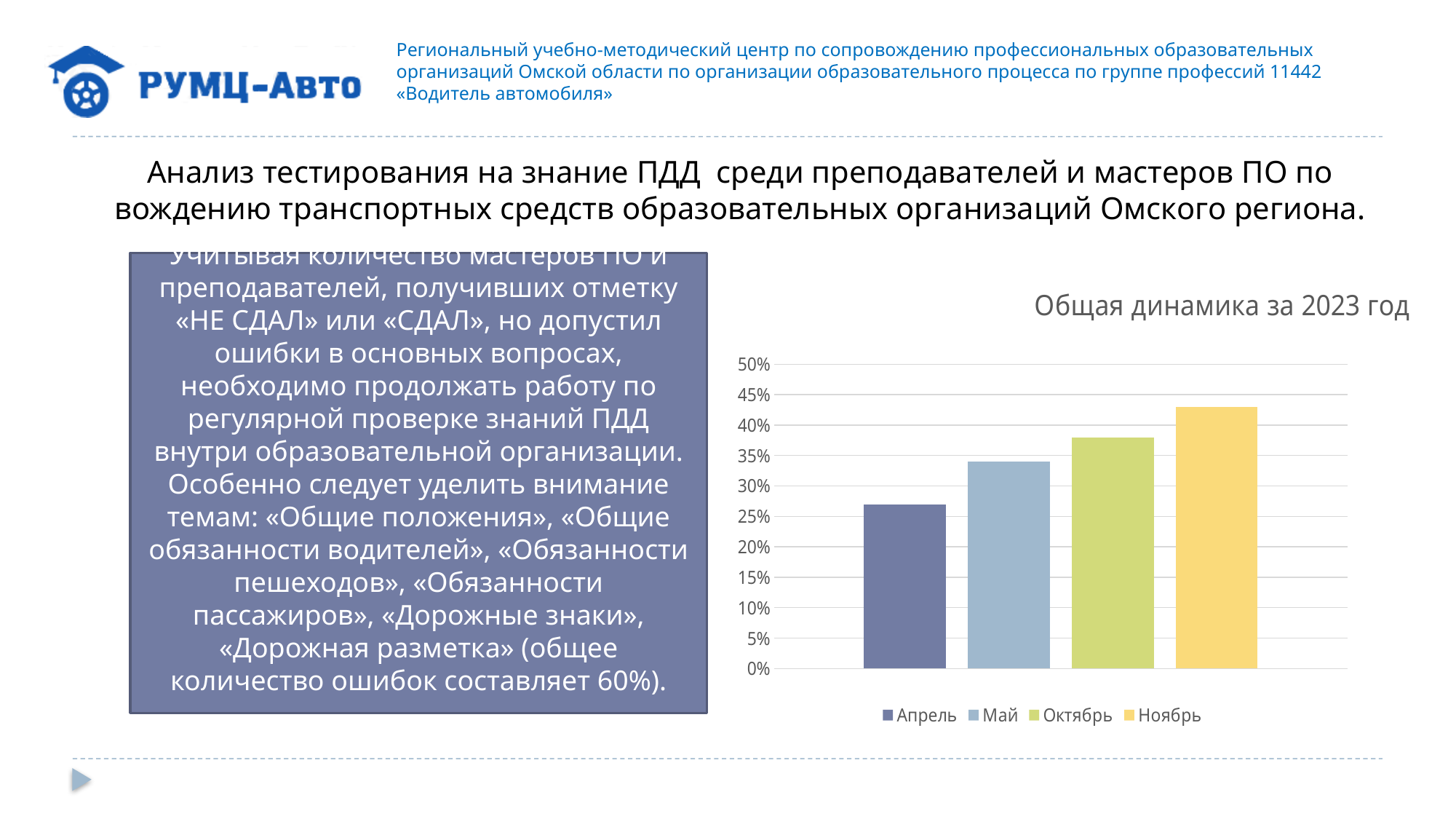
Is the value for Ноябрь greater or less than 40%? greater Which month has the highest bar in the chart? Ноябрь How many entries does the legend of the chart list? 4 Which is larger, the value for Май or the value for Октябрь? Октябрь Is the value for Апрель greater or less than 30%? less Is the value for Май greater or less than 30%? greater Which month has the lowest bar in the chart? Апрель How many bars are plotted in the chart "Общая динамика за 2023 год"? 4 Do the values rise or fall from Апрель to Ноябрь along the x axis? rise What is the title of the chart on the slide? Общая динамика за 2023 год What kind of chart is shown under the title "Общая динамика за 2023 год"? bar chart